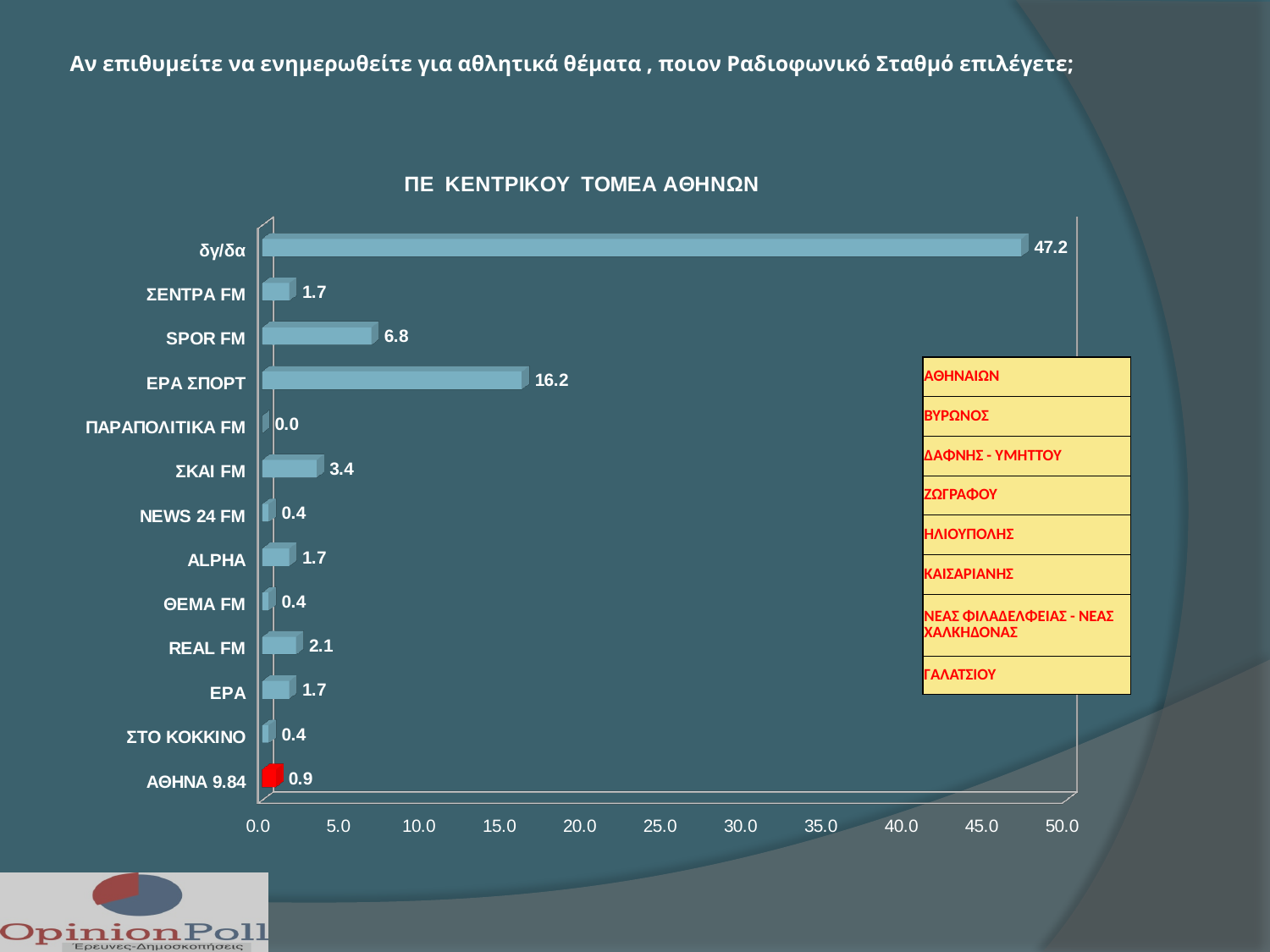
Which category has the highest value? δγ/δα Which category has the lowest value? ΠΑΡΑΠΟΛΙΤΙΚΑ FM What is the title of the chart? ΠΕ ΚΕΝΤΡΙΚΟΥ ΤΟΜΕΑ ΑΘΗΝΩΝ What is the value for ΣΚΑΙ FM? 3.4 What kind of chart is shown on the slide? bar chart What is the value for ΕΡΑ ΣΠΟΡΤ? 16.2 What is the value for ΑΘΗΝΑ 9.84? 0.9 What is the value for SPOR FM? 6.8 What is the difference between the values for ΕΡΑ ΣΠΟΡΤ and SPOR FM? 9.4 Is the value for δγ/δα greater or less than 45.0? greater Which is larger, the value for REAL FM or the value for ΣΚΑΙ FM? ΣΚΑΙ FM How many categories are shown on the chart? 13